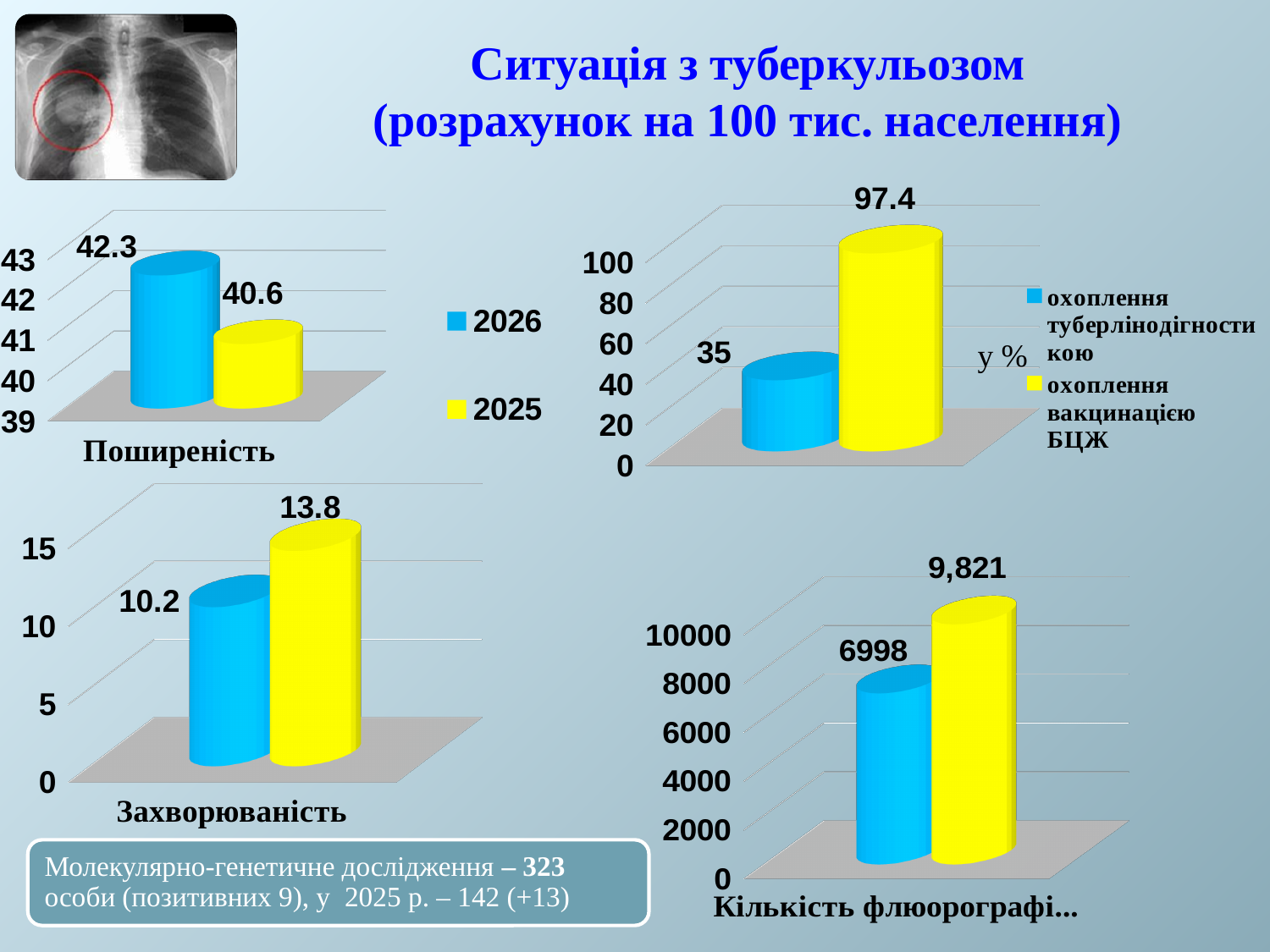
In the chart titled "Захворюваність", what is the value of the yellow bar? 13.8 In the chart titled "Поширеність", what is the value of the yellow bar? 40.6 In the chart titled "Поширеність", what is the difference between the blue bar and the yellow bar? 1.7 In the chart titled "Захворюваність", which bar is higher, the blue one or the yellow one? the yellow one In the top-right chart (у %), how many series does the legend list? 2 In the chart titled "Поширеність", what is the value of the blue bar? 42.3 In the top-right chart (у %), what is the value for "охоплення вакцинацією БЦЖ"? 97.4 In the top-right chart (у %), what is the value for "охоплення туберлінодігностикою"? 35 In the chart titled "Захворюваність", what is the difference between the yellow bar and the blue bar? 3.6 What kind of chart is the chart titled "Поширеність"? bar chart In the chart titled "Кількість флюорографі...", what is the value of the blue bar? 6998 In the chart titled "Кількість флюорографі...", what is the value of the yellow bar? 9,821